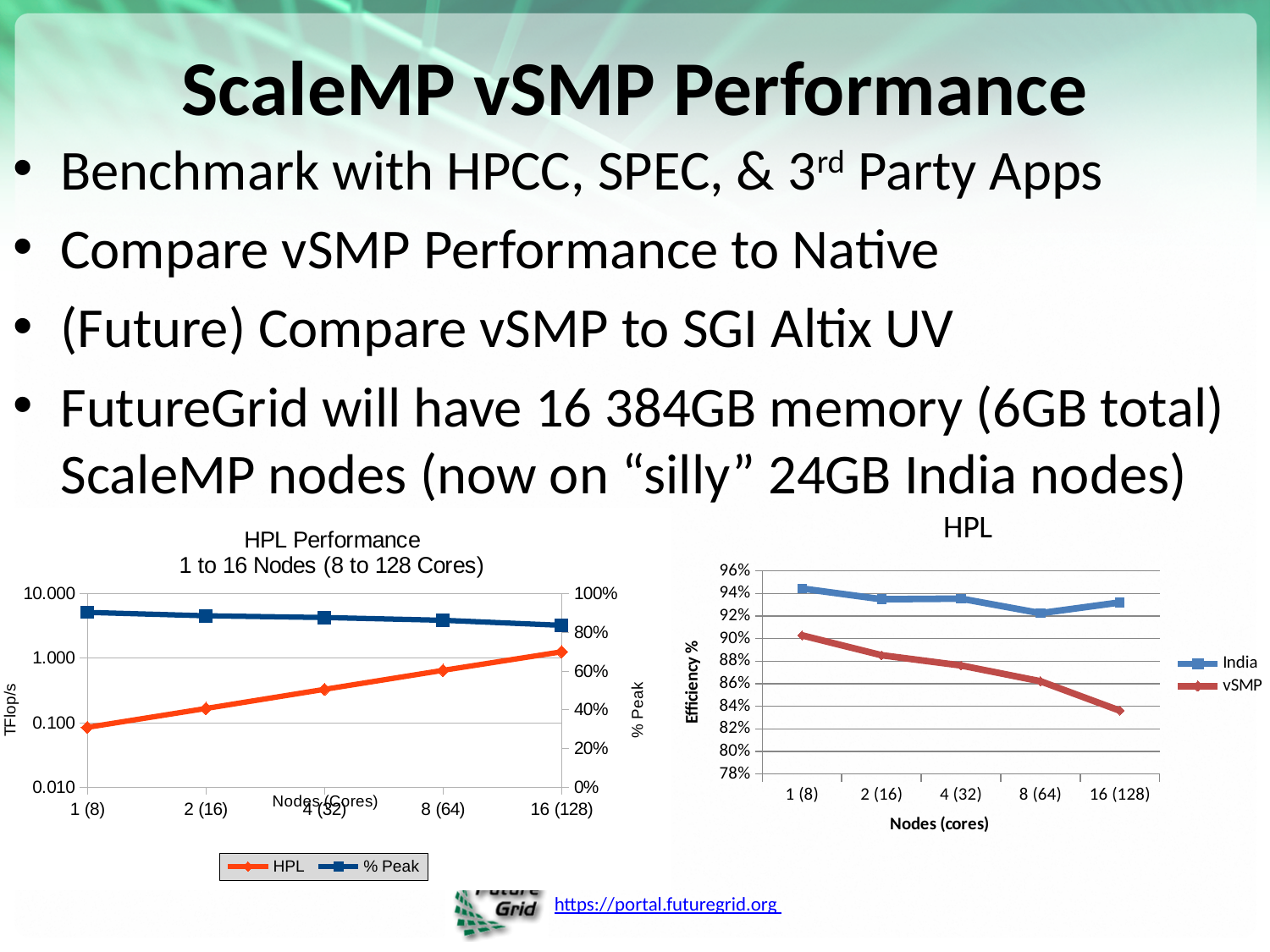
In the HPL chart on the right, at which node configuration is vSMP efficiency lowest? 16 (128) In the HPL chart on the right, how many node configurations are plotted along the x axis? 5 In the HPL chart on the right, how many series does the legend list? 2 In the HPL chart on the right, does the vSMP efficiency rise or fall as the number of nodes increases? Fall In the HPL chart on the right, what kind of chart is used? Line chart In the HPL chart on the right, what are the two series named in the legend? India and vSMP In the HPL chart on the right, at which node configuration is India efficiency lowest? 8 (64) In the HPL chart on the right, is the vSMP efficiency at 4 (32) nodes greater or less than 88%? less In the HPL chart on the right, is the India efficiency at 16 (128) nodes greater or less than 92%? greater In the HPL Performance chart on the left, does the HPL series rise or fall as the number of nodes increases? Rise In the HPL chart on the right, at 16 (128) nodes, which series has the higher efficiency, India or vSMP? India In the HPL Performance chart on the left, is the HPL value at 16 (128) nodes greater or less than 1.000 TFlop/s? greater